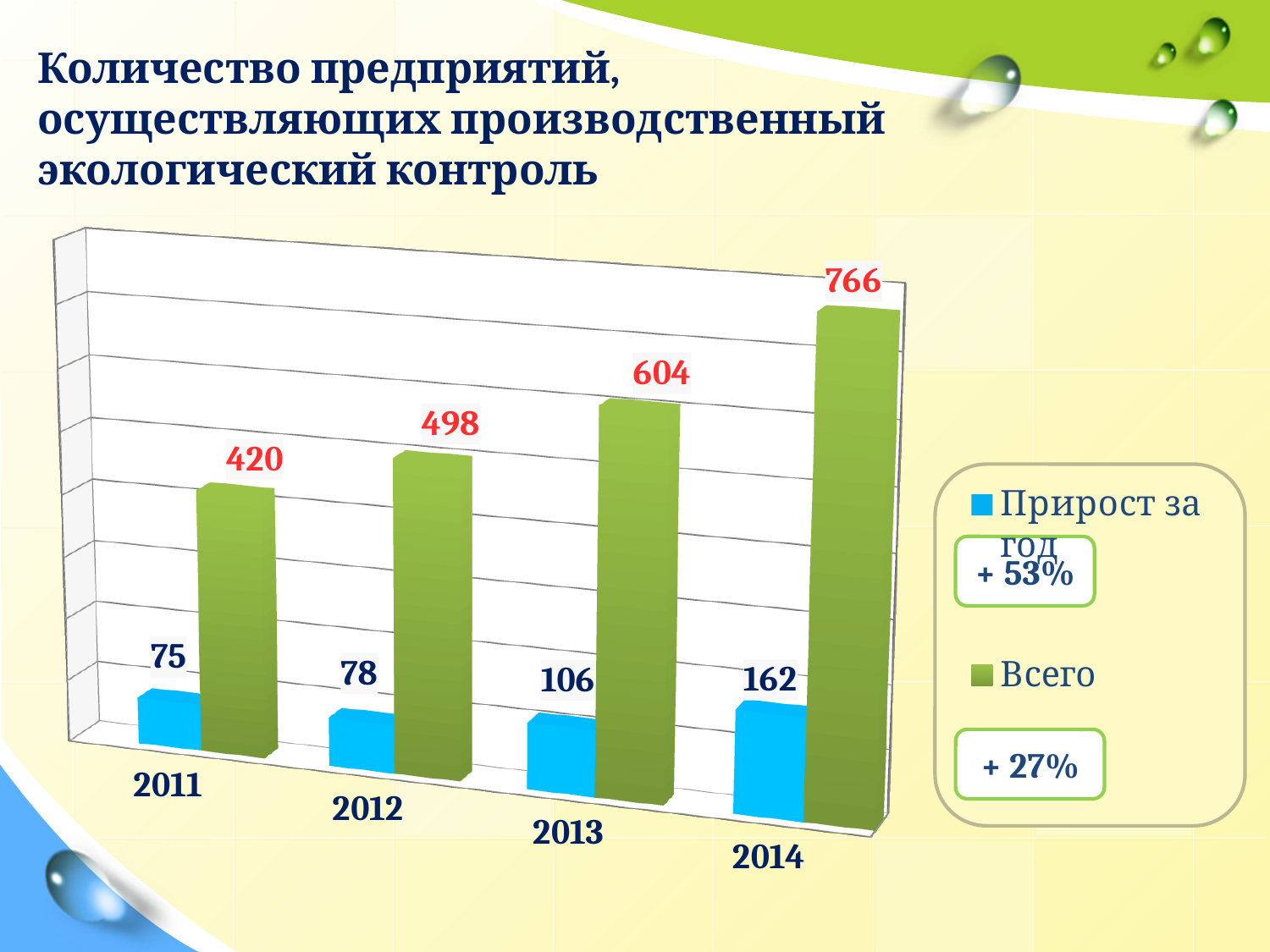
What is the value of "Прирост за год" for 2011? 75 Which is larger: "Прирост за год" for 2012 or for 2014? 2014 What is the difference between the "Всего" values for 2014 and 2013? 162 How many years are shown on the x axis? 4 How many series does the legend list? 2 What is the value of "Прирост за год" for 2013? 106 Which year has the lowest value for "Прирост за год"? 2011 What is the value of "Всего" for 2014? 766 Which year has the highest value for "Всего"? 2014 Do the "Всего" values rise or fall from 2011 to 2014? Rise What kind of chart is shown on the slide? Bar chart What is the value of "Всего" for 2012? 498